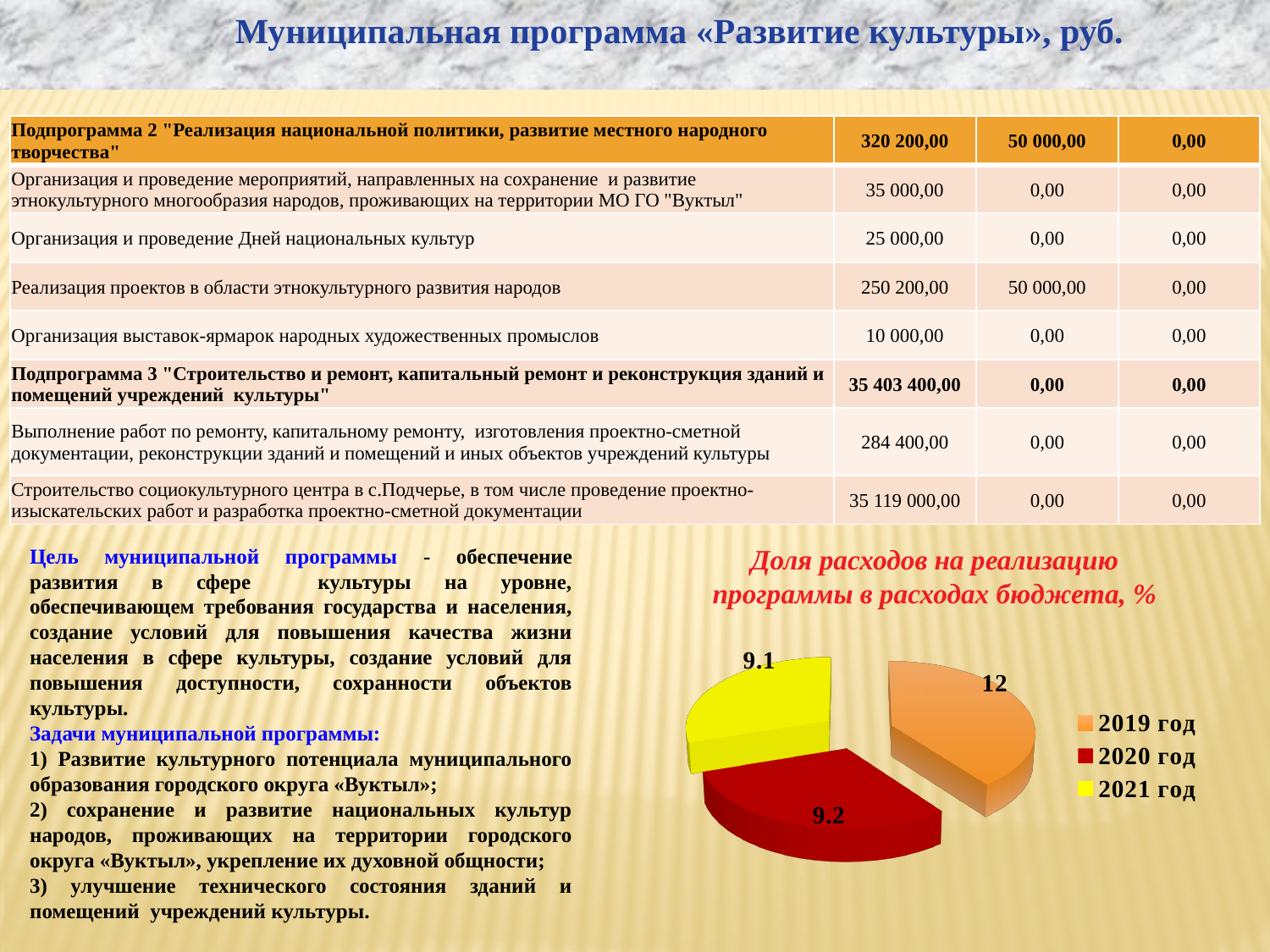
What is the title of the pie chart? Доля расходов на реализацию программы в расходах бюджета, % Which is larger in the pie chart, the value for 2019 год or the value for 2021 год? 2019 год What is the value shown for 2021 год in the pie chart? 9.1 Which year has the smallest value in the pie chart? 2021 год What kind of chart is shown on the slide? Pie chart Which year has the largest slice in the pie chart? 2019 год What is the value shown for 2020 год in the pie chart? 9.2 What is the difference between the values for 2019 год and 2021 год in the pie chart? 2.9 What is the value shown for 2019 год in the pie chart? 12 What is the difference between the values for 2019 год and 2020 год in the pie chart? 2.8 How many entries does the legend of the pie chart list? 3 How many slices does the pie chart have? 3